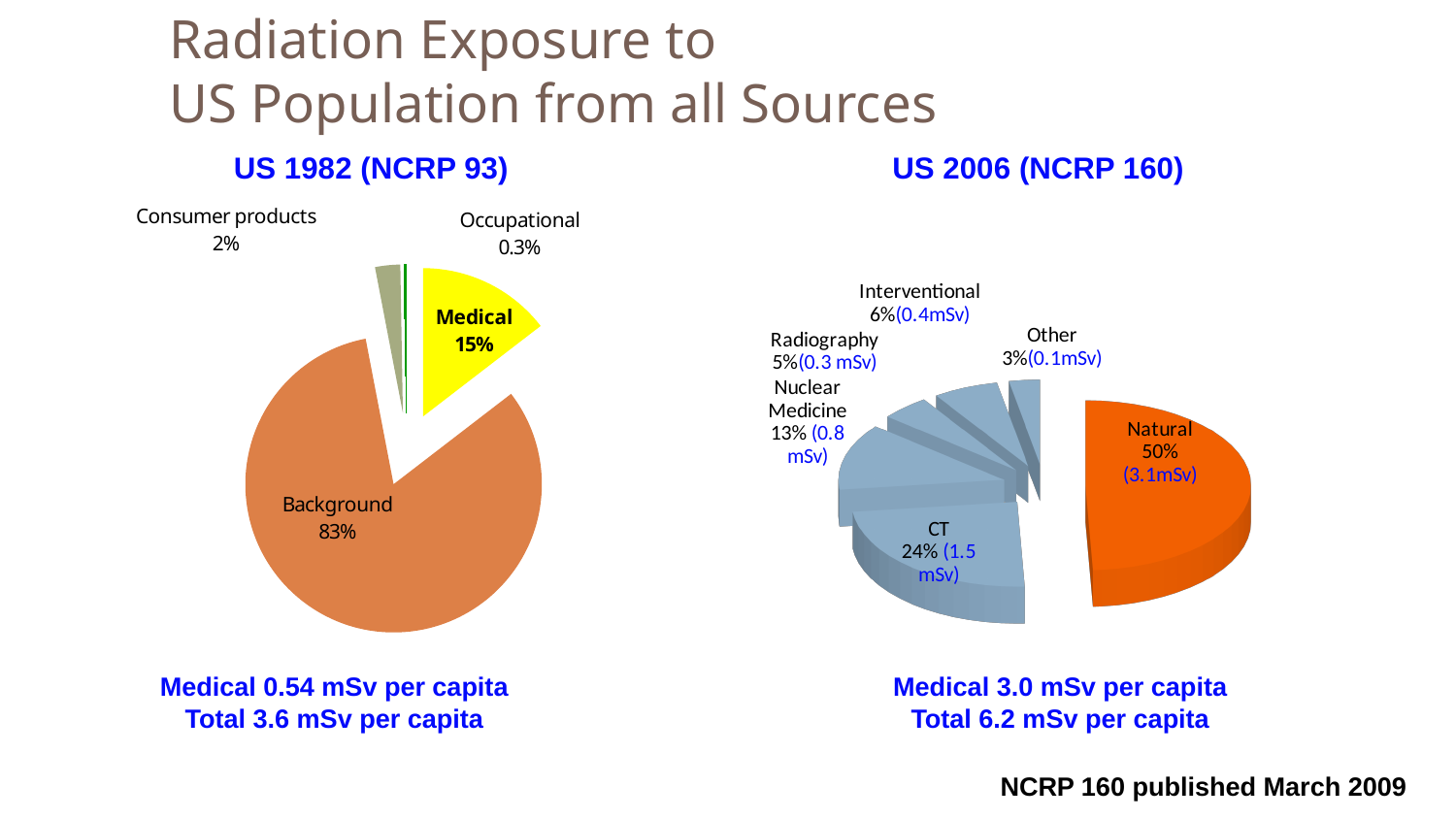
What type of chart is used for the US 2006 (NCRP 160) data? Pie chart In the US 2006 (NCRP 160) chart, what dose in mSv is shown for Nuclear Medicine? 0.8 mSv In the US 2006 (NCRP 160) chart, what is the difference in percentage points between Natural and CT? 26 In the US 1982 (NCRP 93) chart, what percentage is shown for Background? 83% In the US 1982 (NCRP 93) chart, how many categories are shown? 4 In the US 2006 (NCRP 160) chart, what percentage is shown for CT? 24% In the US 2006 (NCRP 160) chart, which is larger, Radiography or Interventional? Interventional In the US 1982 (NCRP 93) chart, which category has the smallest share? Occupational In the US 1982 (NCRP 93) chart, what percentage is shown for Medical? 15% In the US 1982 (NCRP 93) chart, which category has the largest share? Background In the US 1982 (NCRP 93) chart, what percentage is shown for Occupational? 0.3% In the US 2006 (NCRP 160) chart, which category has the largest share? Natural